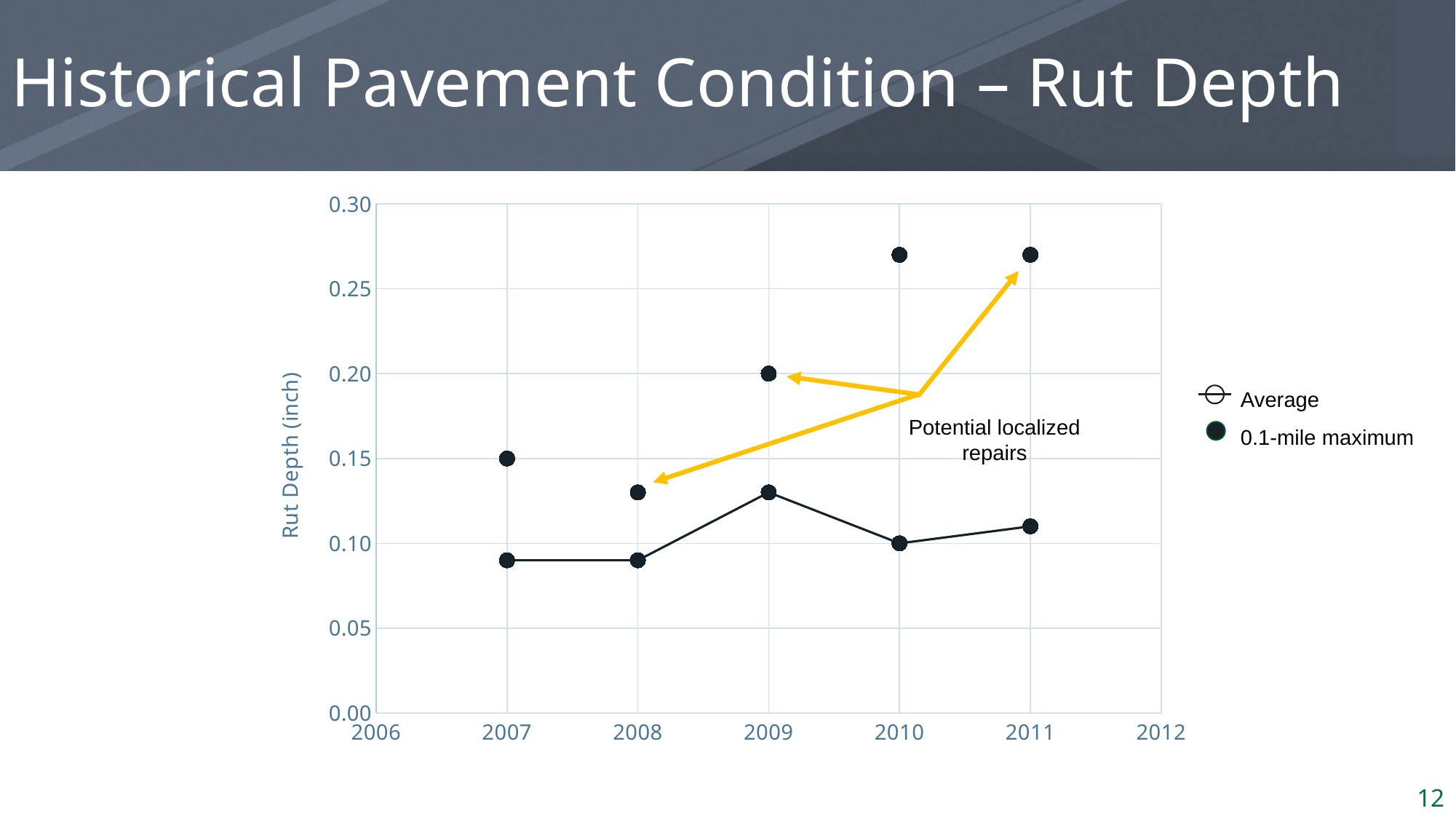
In which year is the 0.1-mile maximum rut depth lowest? 2008 How many series does the legend list? 2 What kind of chart is shown on the slide? line chart What is the 0.1-mile maximum rut depth in 2007? 0.15 What is the Average rut depth in 2010? 0.10 What is the 0.1-mile maximum rut depth in 2009? 0.20 Is the 0.1-mile maximum rut depth in 2010 greater or less than 0.25? greater Is the Average rut depth in 2007 greater or less than 0.10? less In which year is the Average rut depth highest? 2009 What is the title of the vertical axis? Rut Depth (inch) How many years have data points plotted? 5 In 2009, which series has the larger value, Average or 0.1-mile maximum? 0.1-mile maximum